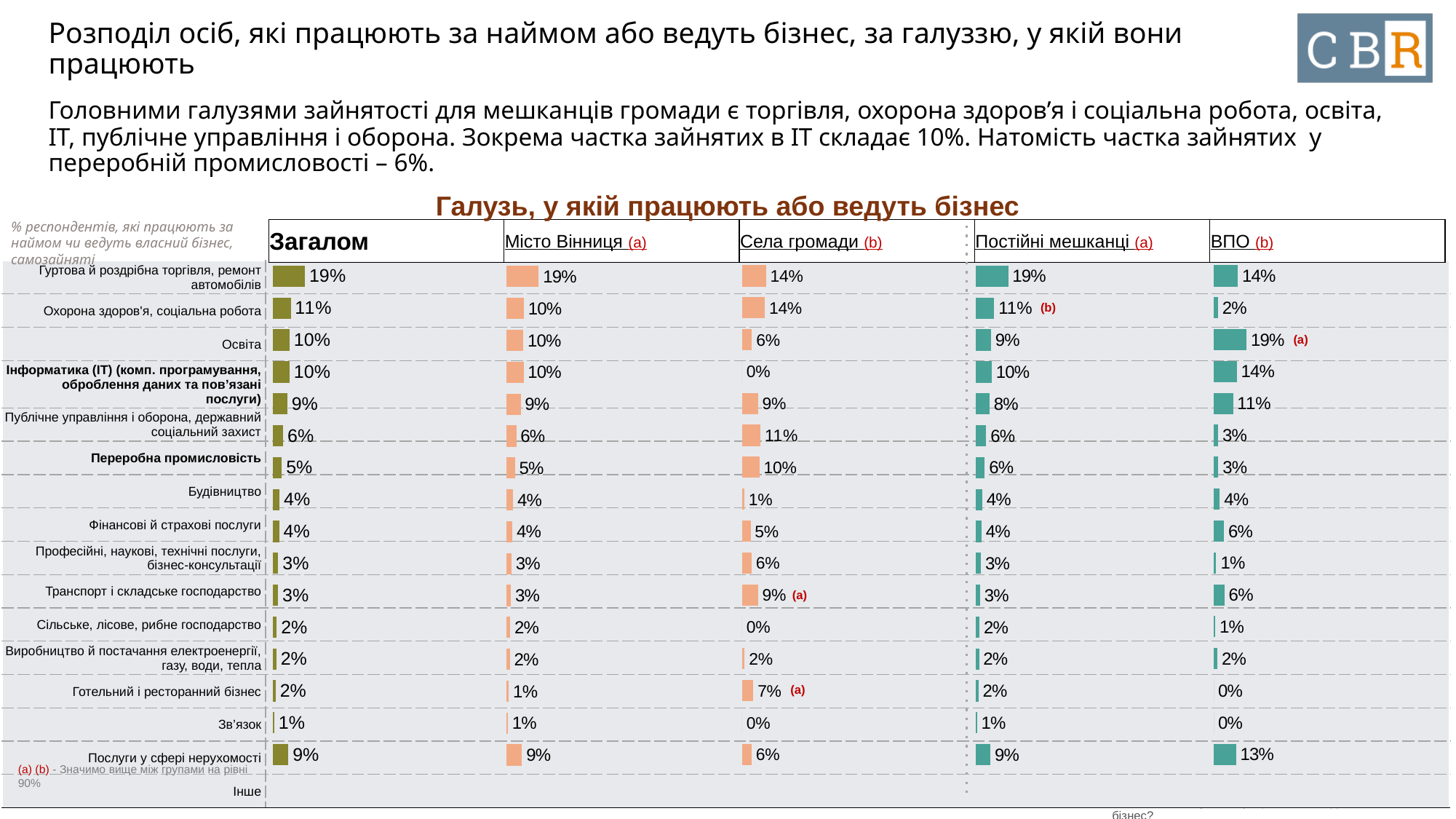
What is the difference between the Місто Вінниця and Села громади values for Гуртова й роздрібна торгівля, ремонт автомобілів? 5 percentage points How many respondent groups (columns) does the chart show? 5 Which group has the highest value for Освіта? ВПО What is the value for Освіта in the Місто Вінниця column? 10% What is the value for Гуртова й роздрібна торгівля, ремонт автомобілів in the Загалом column? 19% For Охорона здоров'я, соціальна робота, which is larger: the Села громади value or the ВПО value? Села громади What is the title of the chart? Галузь, у якій працюють або ведуть бізнес What is the difference between the ВПО and Постійні мешканці values for Освіта? 10 percentage points What kind of chart is shown on the slide? Bar chart Which industry has the highest value in the Загалом column? Гуртова й роздрібна торгівля, ремонт автомобілів What is the value for Освіта in the ВПО column? 19% What is the value for Охорона здоров'я, соціальна робота in the Села громади column? 14%